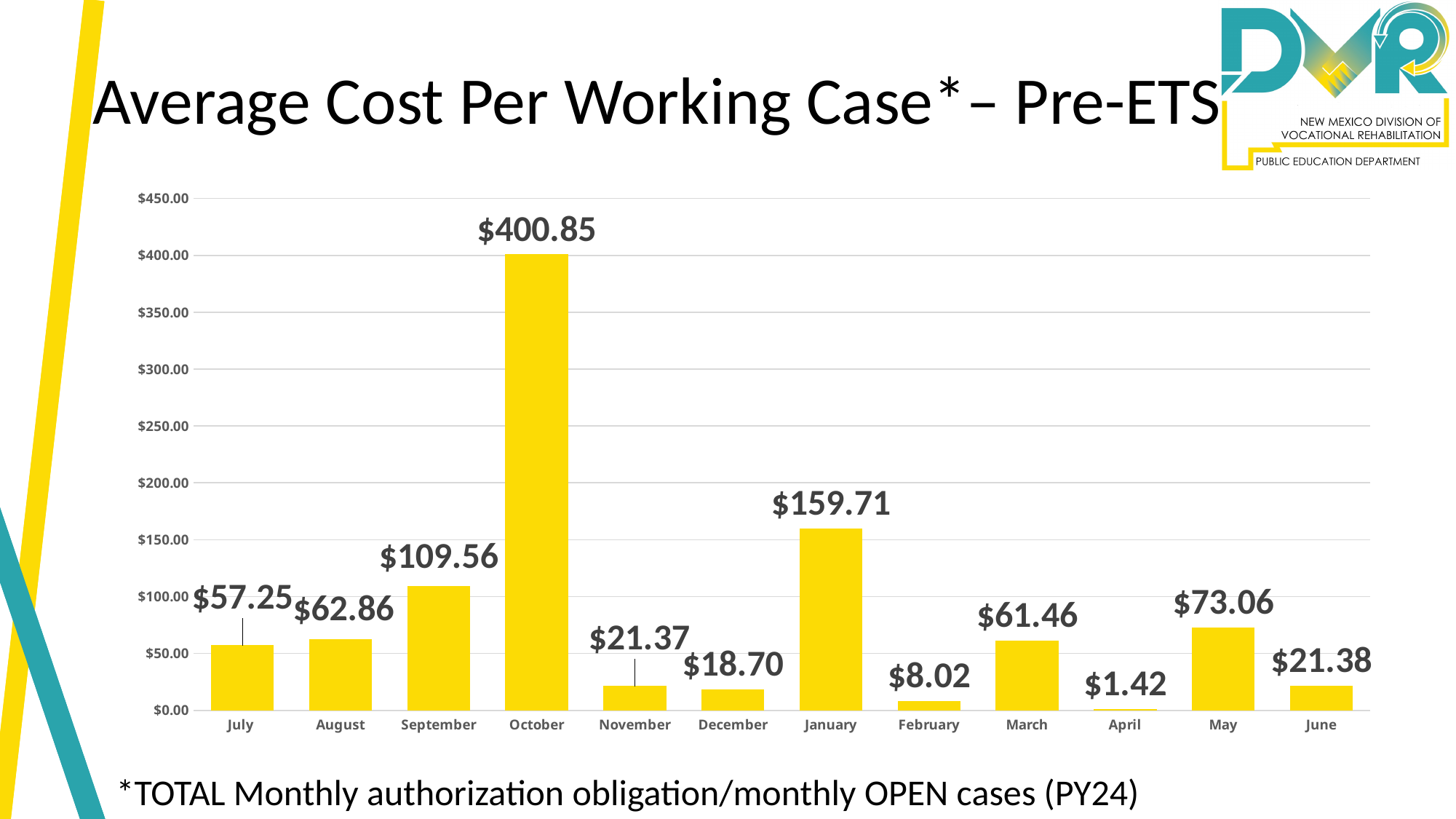
What is the average cost per working case for April? $1.42 What is the average cost per working case for October? $400.85 What is the difference between the October and January values? $241.14 Which month has the lowest average cost per working case? April What is the average cost per working case for January? $159.71 How many months are shown on the x axis? 12 What is the difference between the May and March values? $11.60 Which is larger, the value for September or the value for May? September Is the value for January greater or less than $150.00? greater What kind of chart is shown on the slide? Bar chart What is the title of the chart on the slide? Average Cost Per Working Case* – Pre-ETS Which month has the highest average cost per working case? October